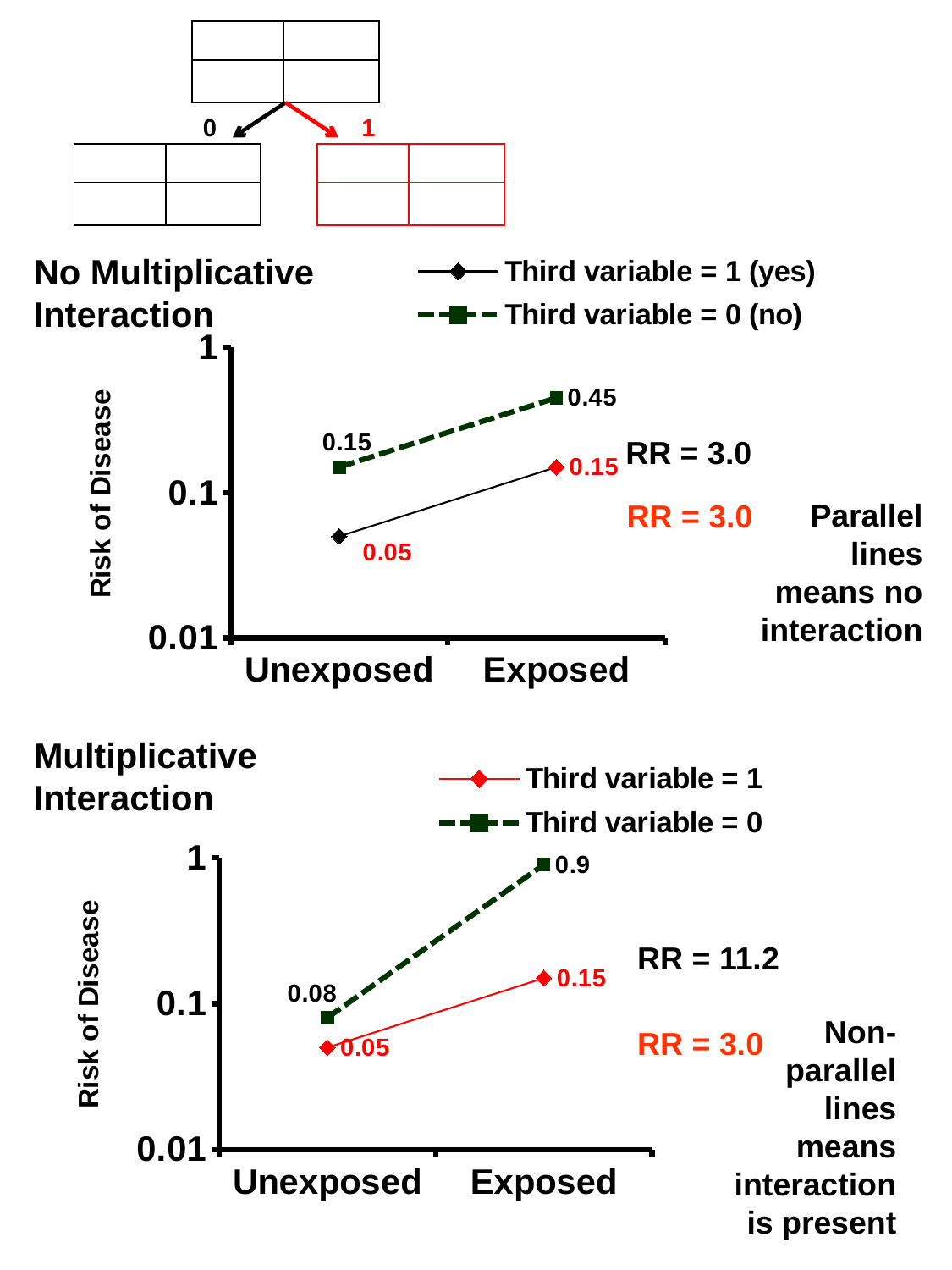
What is the y-axis label of the 'No Multiplicative Interaction' chart? Risk of Disease How many series does the legend of the 'No Multiplicative Interaction' chart list? 2 In the 'No Multiplicative Interaction' chart, what is the difference in risk of disease between the Exposed and Unexposed groups for the third variable = 0 (no) series? 0.30 How many categories are shown on the x axis of the 'Multiplicative Interaction' chart? 2 What kind of chart is the 'Multiplicative Interaction' chart? Line chart In the 'No Multiplicative Interaction' chart, does the risk of disease for the third variable = 1 (yes) series rise or fall from Unexposed to Exposed? Rise In the 'Multiplicative Interaction' chart, what is the difference in risk of disease between the two series for the Exposed group? 0.75 In the 'Multiplicative Interaction' chart, what is the risk of disease for the Unexposed group when the third variable = 0? 0.08 In the 'No Multiplicative Interaction' chart, what is the risk of disease for the Exposed group when the third variable = 0 (no)? 0.45 In the 'No Multiplicative Interaction' chart, what is the risk of disease for the Unexposed group when the third variable = 1 (yes)? 0.05 In the 'Multiplicative Interaction' chart, which series has the higher risk of disease for the Exposed group? Third variable = 0 In the 'Multiplicative Interaction' chart, what is the risk of disease for the Exposed group when the third variable = 0? 0.9